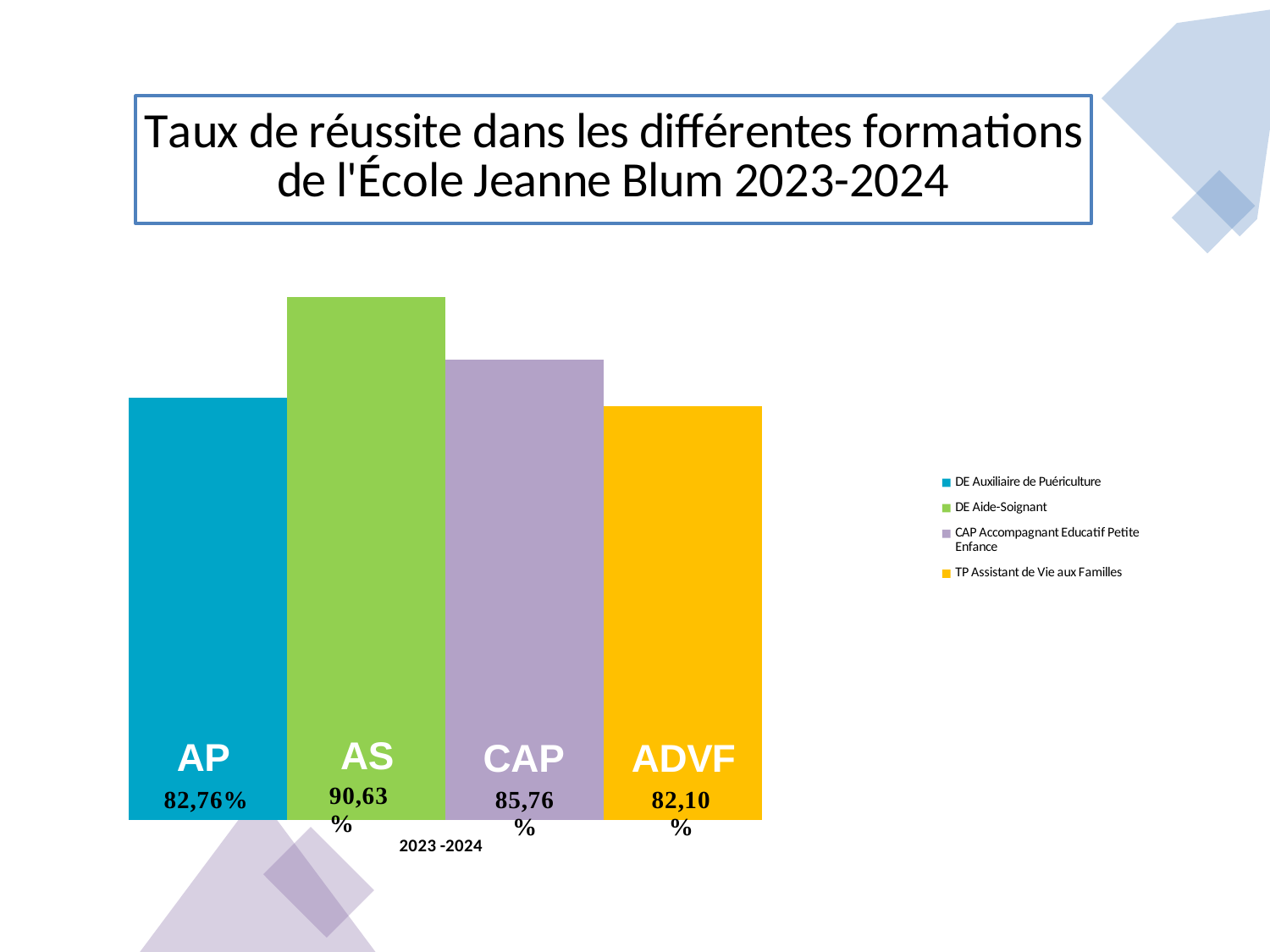
What is the success rate shown for CAP? 85,76 % How many series does the legend list? 4 What is the success rate shown for AP (DE Auxiliaire de Puériculture)? 82,76% What type of chart is shown on the slide? Bar chart What is the difference between the success rates of CAP and ADVF? 3,66 % Which formation has the lowest success rate? ADVF Which formation has the highest success rate? AS Which has a higher success rate, CAP or AS? AS What is the difference between the success rates of AS and AP? 7,87 % How many formations (bars) are shown in the chart? 4 What is the success rate shown for AS (DE Aide-Soignant)? 90,63 % What is the success rate shown for ADVF? 82,10 %